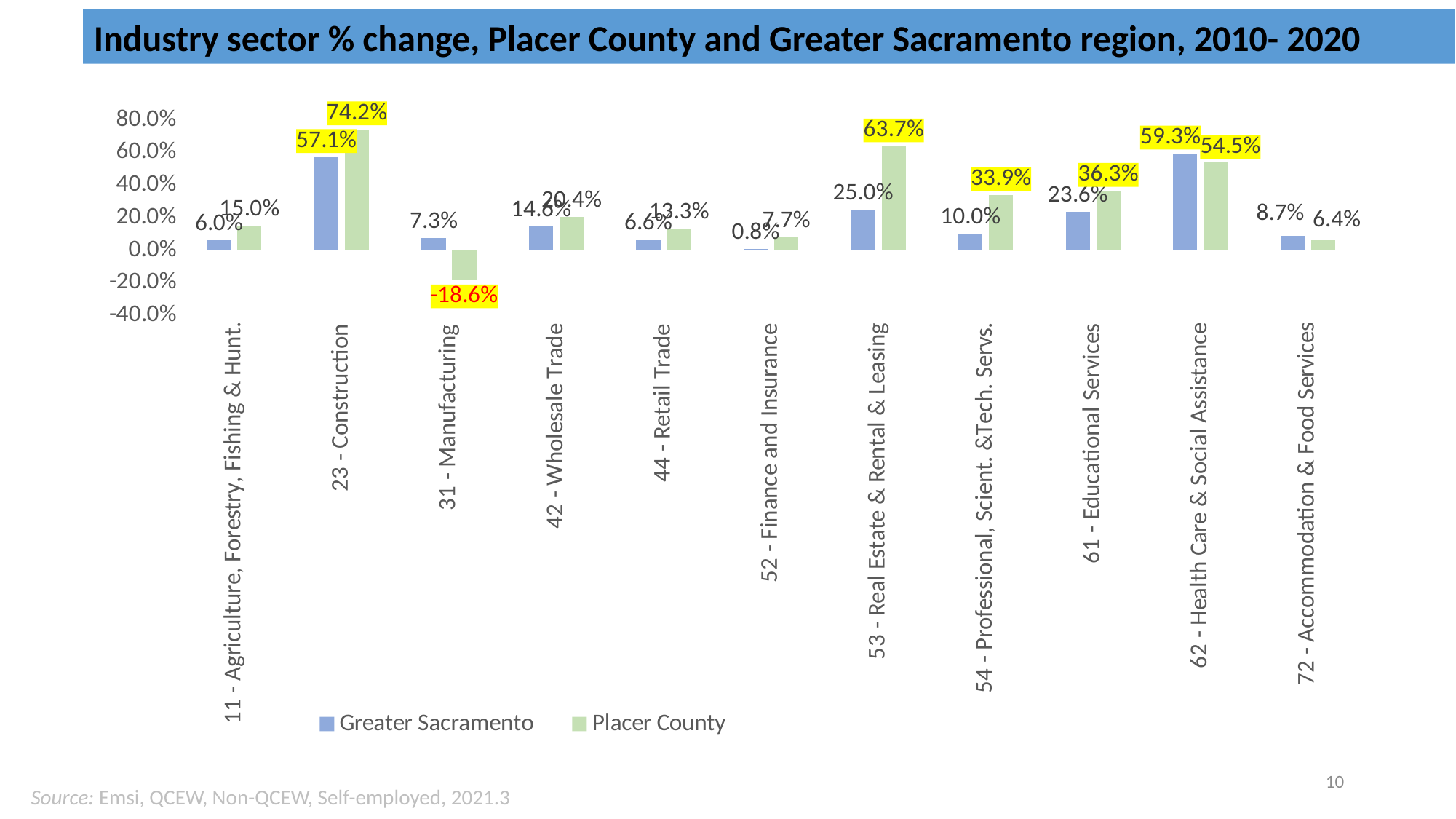
Which series is shown in green in the legend? Placer County How many series does the legend list? 2 What is the Placer County % change for 31 - Manufacturing? -18.6% What type of chart is shown on the slide? bar chart For 62 - Health Care & Social Assistance, which is larger: the Greater Sacramento or the Placer County % change? Greater Sacramento Which sector has the lowest Greater Sacramento % change? 52 - Finance and Insurance What is the Greater Sacramento % change for 62 - Health Care & Social Assistance? 59.3% How many industry sectors are shown on the x axis? 11 Which sector has the lowest Placer County % change? 31 - Manufacturing What is the Placer County % change for 23 - Construction? 74.2% What is the difference between the Placer County and Greater Sacramento % change for 53 - Real Estate & Rental & Leasing? 38.7% Which sector has the highest Placer County % change? 23 - Construction